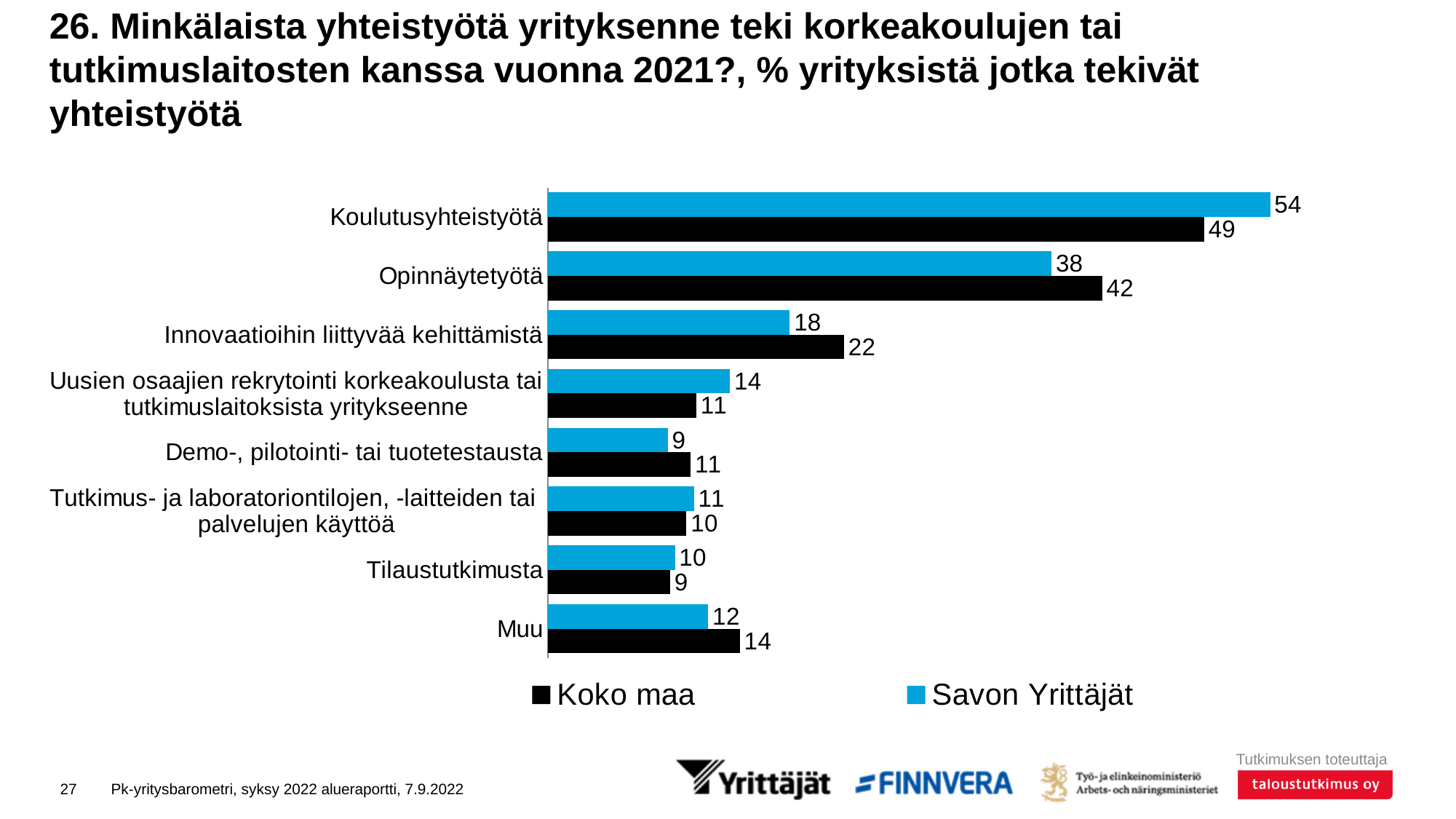
What is the value for Koko maa for Innovaatioihin liittyvää kehittämistä? 22 Which category has the highest value for Koko maa? Koulutusyhteistyötä What is the value for Savon Yrittäjät for Tilaustutkimusta? 10 Which colour represents Savon Yrittäjät in the chart? Blue For Opinnäytetyötä, which series has the larger value, Koko maa or Savon Yrittäjät? Koko maa What is the value for Koko maa for Opinnäytetyötä? 42 What is the value for Savon Yrittäjät for Koulutusyhteistyötä? 54 How many series does the legend list? 2 How many categories are shown on the chart? 8 What kind of chart is shown on the slide? Bar chart What is the difference between the Savon Yrittäjät and Koko maa values for Koulutusyhteistyötä? 5 Which category has the lowest value for Savon Yrittäjät? Demo-, pilotointi- tai tuotetestausta